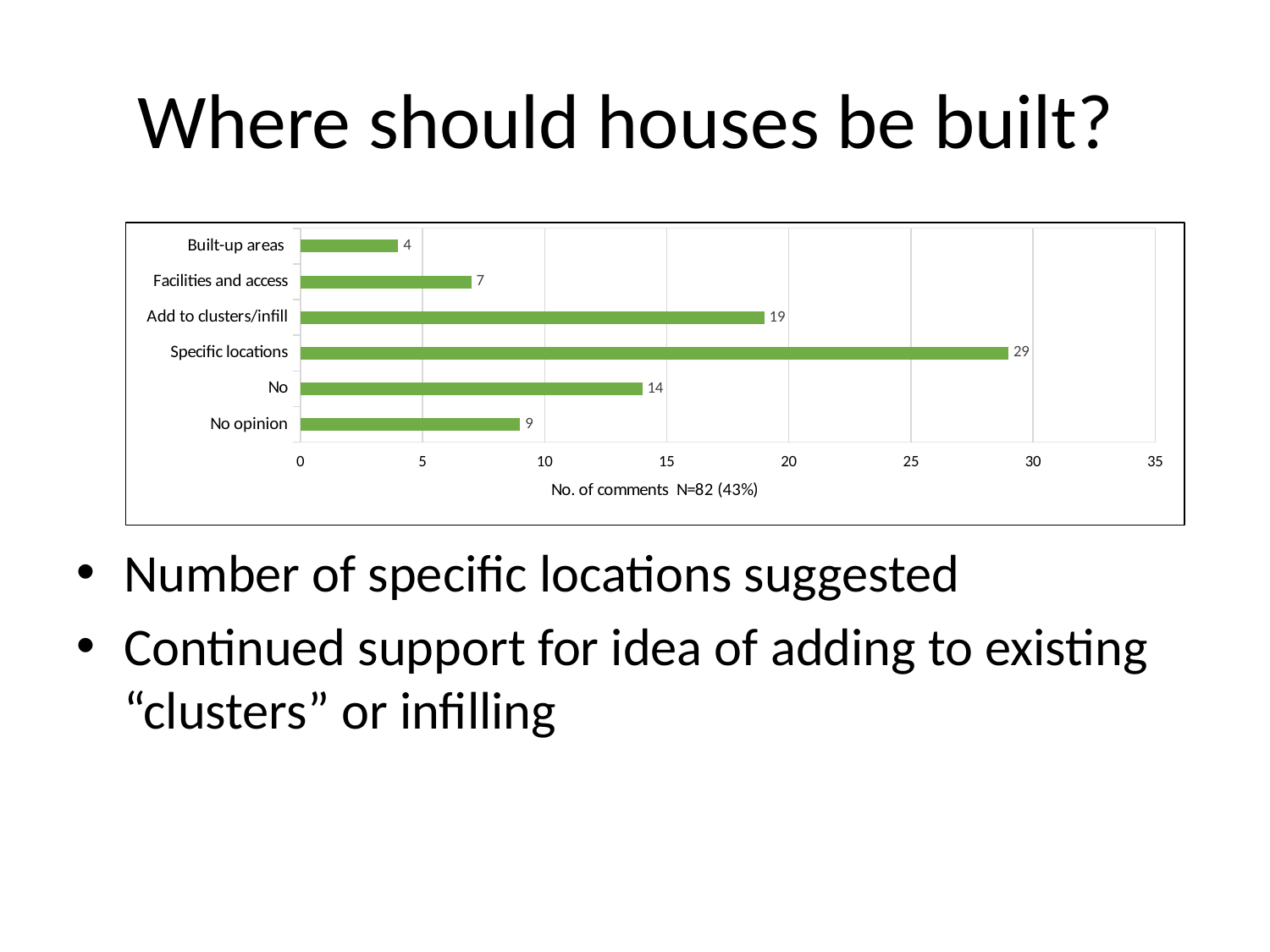
Which category has the highest number of comments? Specific locations What is the difference in number of comments between No and Facilities and access? 7 What is the label on the horizontal axis of the chart? No. of comments N=82 (43%) Which has more comments, No or No opinion? No What is the number of comments for Specific locations? 29 What is the number of comments for Add to clusters/infill? 19 What is the number of comments for No opinion? 9 What is the difference in number of comments between Specific locations and Add to clusters/infill? 10 Which category has the lowest number of comments? Built-up areas What type of chart is shown on the slide? Bar chart How many categories are shown in the chart? 6 What is the number of comments for Built-up areas? 4